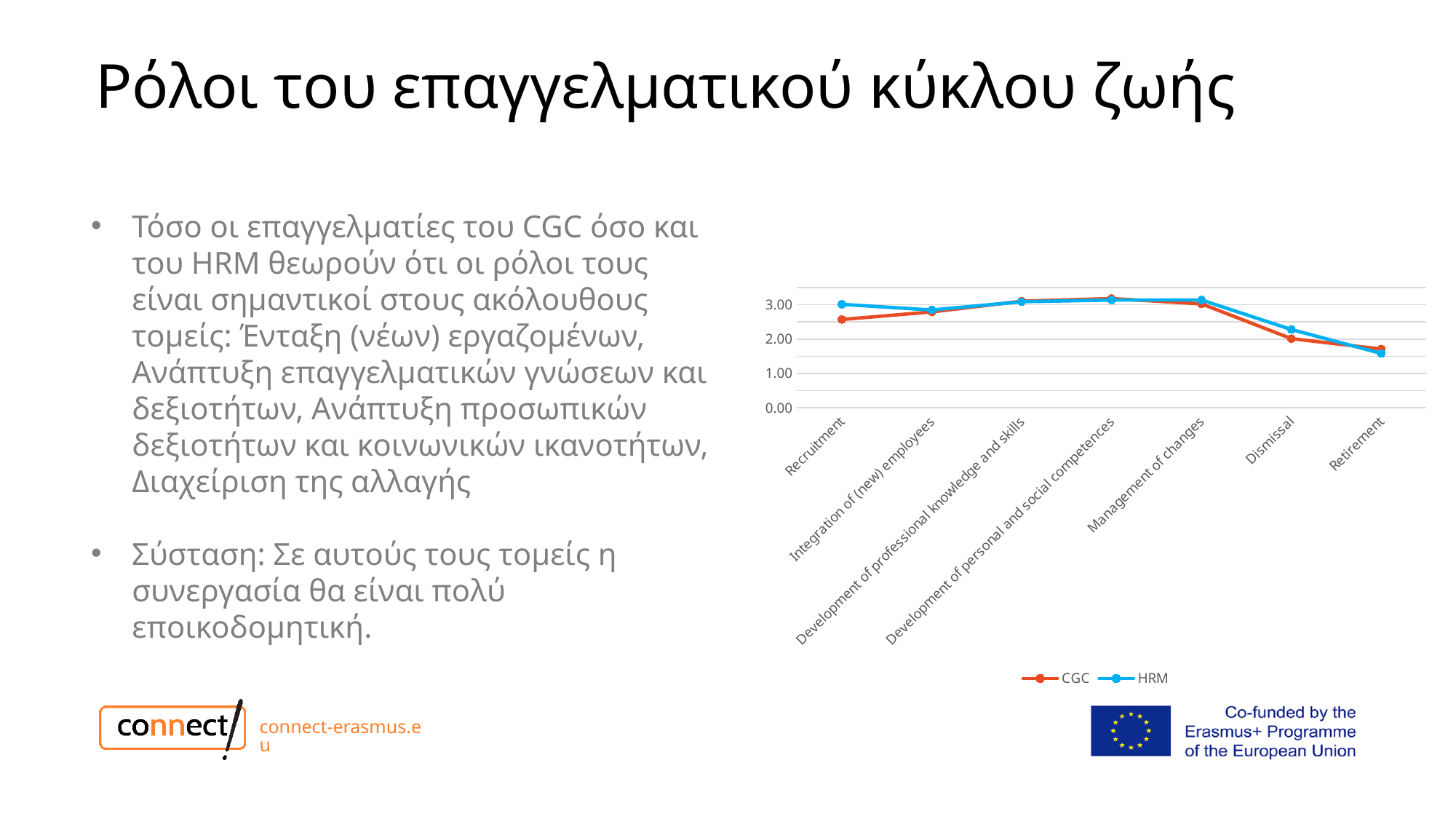
Is the CGC value for Development of personal and social competences greater or less than 3.00? greater For the HRM series, which category has the lowest value? Retirement Which two series are listed in the chart legend? CGC and HRM How many categories are plotted along the x axis of the chart? 7 Is the CGC value for Recruitment greater or less than 2.00? greater How many series does the chart legend list? 2 Is the CGC value for Recruitment greater or less than 3.00? less At Recruitment, which series has the higher value, CGC or HRM? HRM Do the values for both series rise or fall from Management of changes to Retirement? fall What kind of chart is shown on the slide? line chart